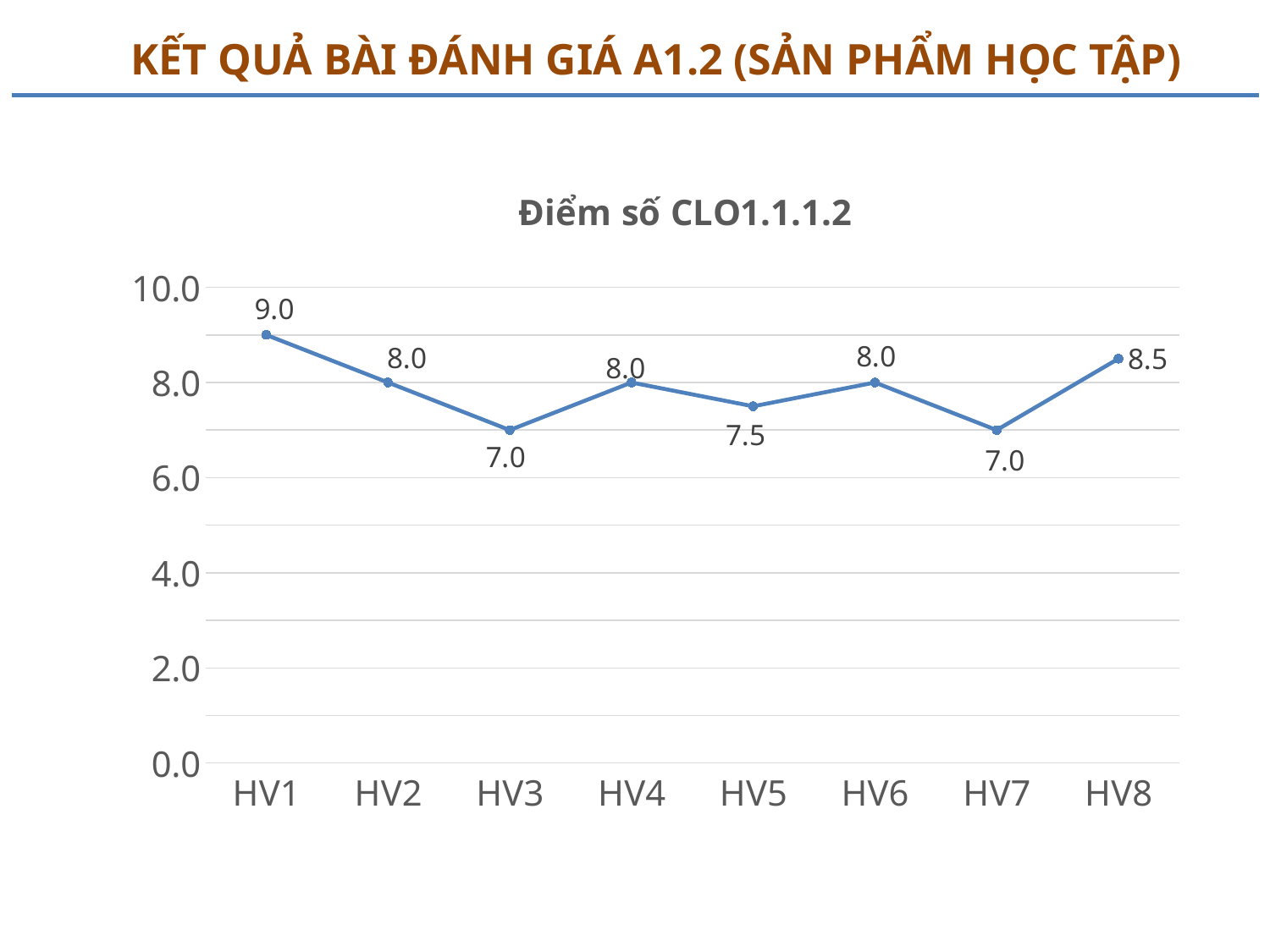
What is the value for HV1? 9.0 Which is larger, the value for HV2 or the value for HV5? HV2 What kind of chart is shown on the slide? line chart What is the difference between the values for HV1 and HV3? 2.0 What is the value for HV8? 8.5 Do the values rise or fall from HV1 to HV3? fall Which category has the highest value? HV1 What is the difference between the values for HV8 and HV7? 1.5 What is the title of the chart? Điểm số CLO1.1.1.2 How many categories are shown on the x axis? 8 What is the value for HV5? 7.5 Is the value for HV4 greater or less than 6.0? greater